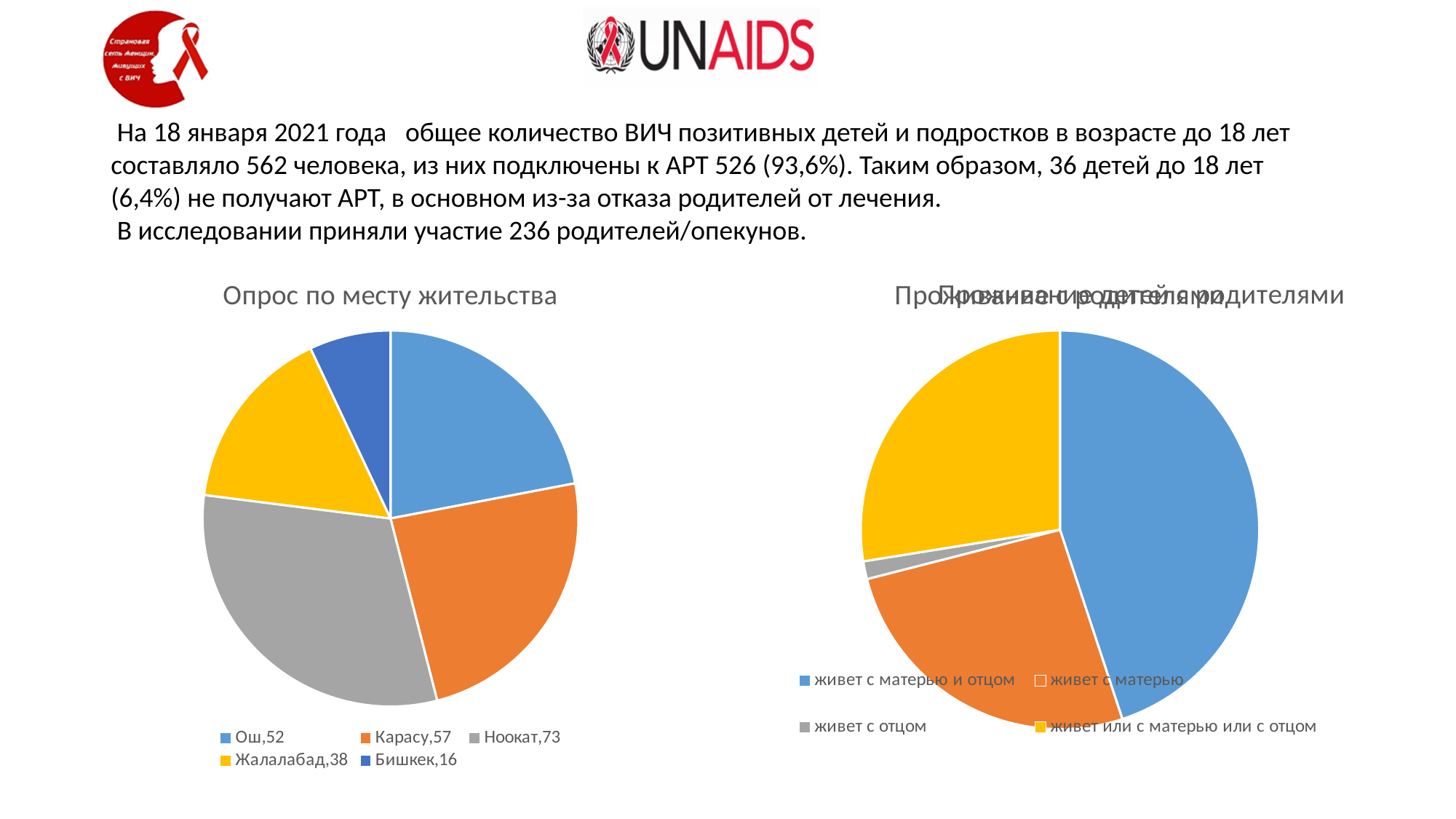
In the pie chart on the right side of the slide, which category has the smallest slice? живет с отцом In the left pie chart 'Опрос по месту жительства', which category has the lowest value? Бишкек How many categories does the left pie chart 'Опрос по месту жительства' show? 5 In the left pie chart 'Опрос по месту жительства', which category has the highest value? Ноокат What kind of chart is the chart on the right side of the slide? Pie chart How many categories does the legend of the pie chart on the right side of the slide list? 4 In the left pie chart 'Опрос по месту жительства', what is the value for Бишкек? 16 What is the total of all values in the left pie chart 'Опрос по месту жительства'? 236 In the left pie chart 'Опрос по месту жительства', what is the difference between the values for Ноокат and Ош? 21 In the left pie chart 'Опрос по месту жительства', which is larger, Карасу or Жалалабад? Карасу In the left pie chart 'Опрос по месту жительства', what is the value for Ноокат? 73 In the pie chart on the right side of the slide, which category has the largest slice? живет с матерью и отцом